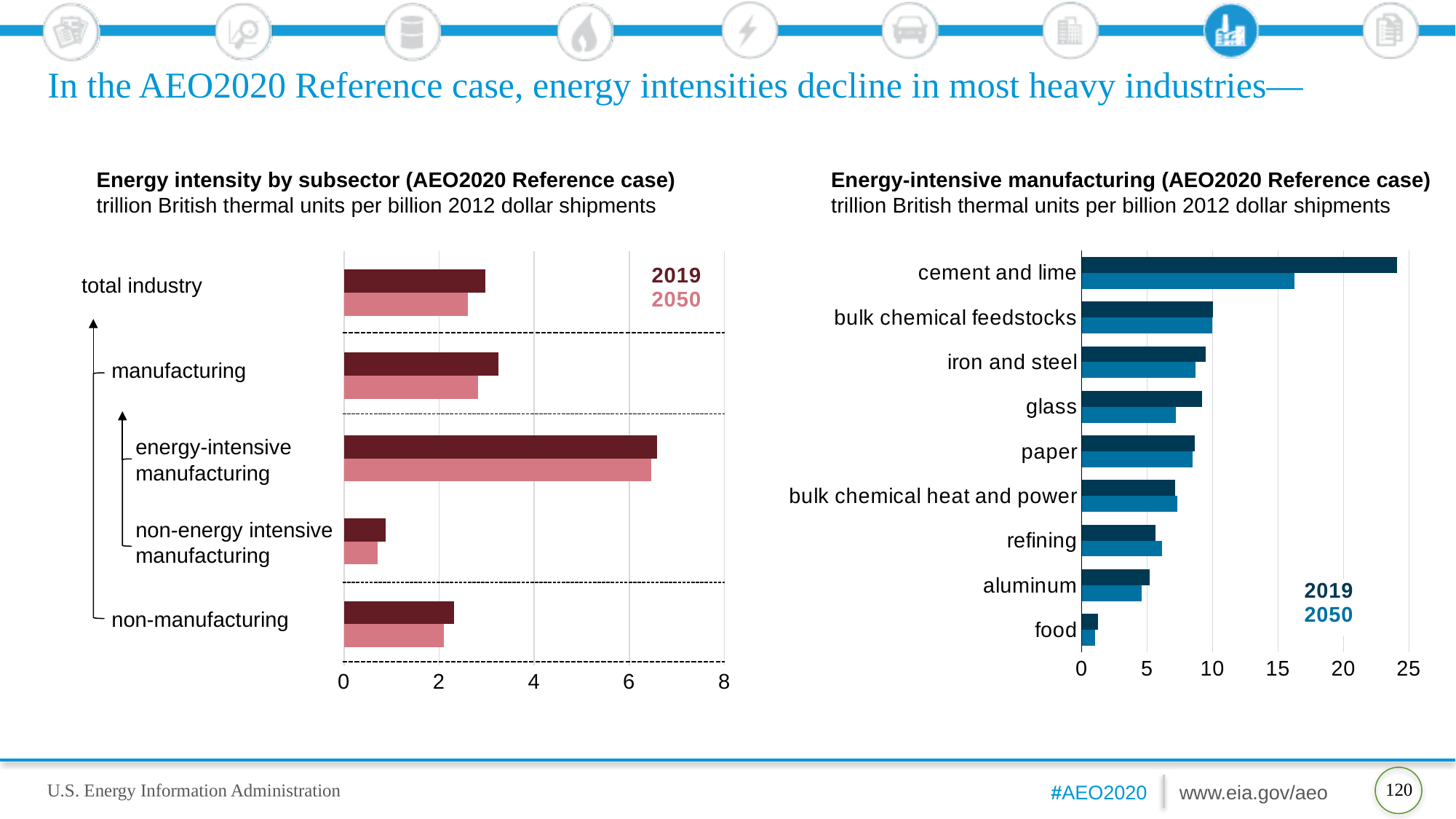
In the 'Energy intensity by subsector' chart on the left, which subsector has the highest energy intensity in 2019? energy-intensive manufacturing In the 'Energy-intensive manufacturing' chart on the right, which year has the larger value for cement and lime, 2019 or 2050? 2019 In the 'Energy-intensive manufacturing' chart on the right, which industry has the lowest energy intensity in 2019? food In the 'Energy intensity by subsector' chart on the left, which subsector has the lowest energy intensity in 2050? non-energy intensive manufacturing How many industry categories are shown in the 'Energy-intensive manufacturing' chart on the right? 9 In the 'Energy-intensive manufacturing' chart on the right, is the 2019 value for cement and lime greater or less than 20? greater In the 'Energy intensity by subsector' chart on the left, is the 2019 value for total industry greater or less than 4? less What kind of chart is the 'Energy intensity by subsector (AEO2020 Reference case)' chart on the left? bar chart In the 'Energy intensity by subsector' chart on the left, is the 2019 value for energy-intensive manufacturing greater or less than 6? greater How many subsector categories are shown in the 'Energy intensity by subsector' chart on the left? 5 In the 'Energy-intensive manufacturing (AEO2020 Reference case)' chart on the right, which industry has the highest energy intensity in 2019? cement and lime How many series does the legend list in the 'Energy intensity by subsector' chart on the left? 2